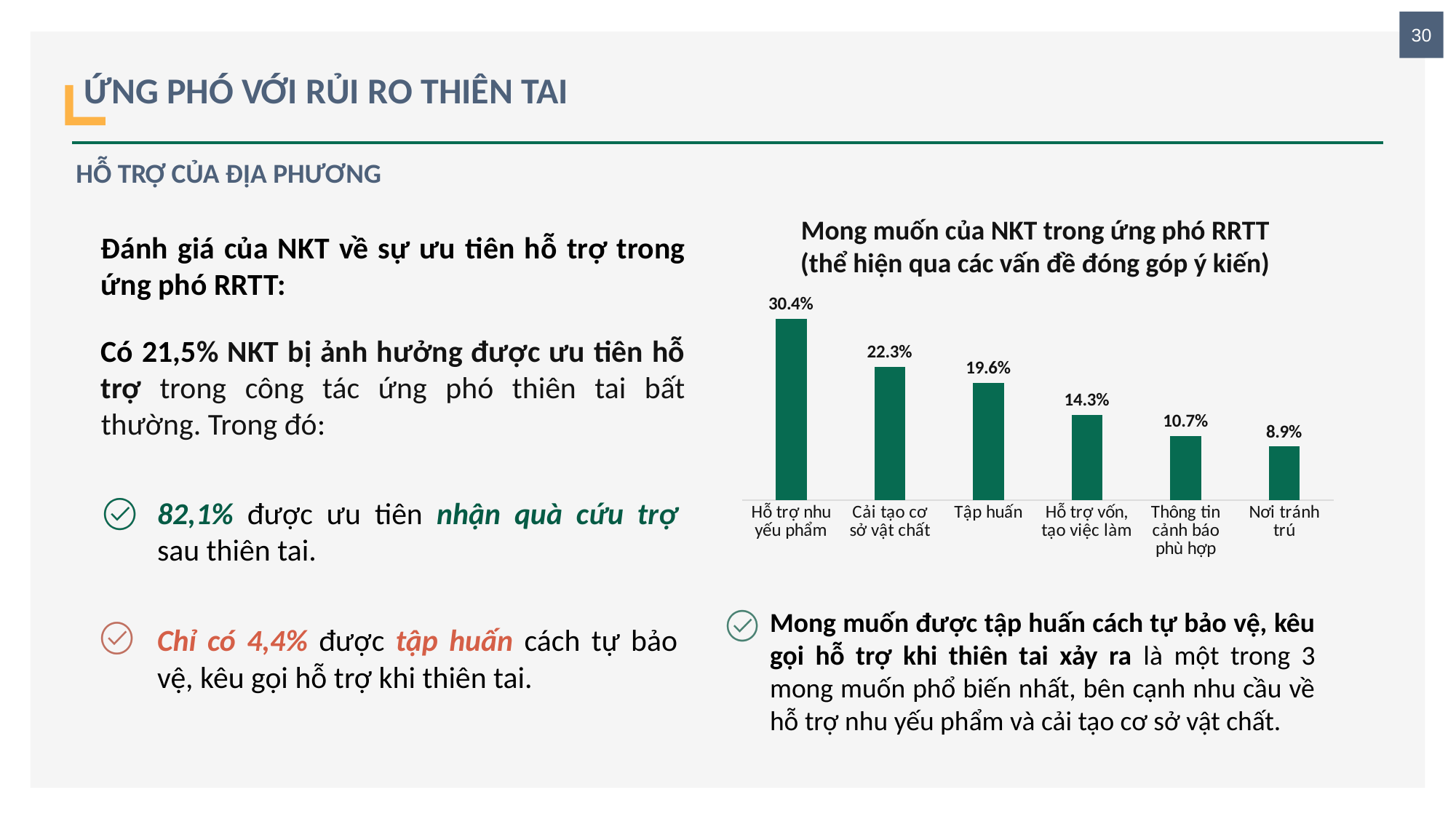
How many categories are shown in the chart? 6 What is the value for "Tập huấn" in the chart? 19.6% Do the values rise or fall from left to right across the chart? Fall Which is larger, the value for "Cải tạo cơ sở vật chất" or the value for "Tập huấn"? Cải tạo cơ sở vật chất What is the value for "Nơi tránh trú" in the chart? 8.9% What is the difference between the values for "Hỗ trợ nhu yếu phẩm" and "Cải tạo cơ sở vật chất"? 8.1% Which category has the highest value in the chart? Hỗ trợ nhu yếu phẩm What is the difference between the values for "Hỗ trợ vốn, tạo việc làm" and "Nơi tránh trú"? 5.4% What is the value for "Thông tin cảnh báo phù hợp" in the chart? 10.7% What is the value for "Hỗ trợ nhu yếu phẩm" in the chart? 30.4% Which category has the lowest value in the chart? Nơi tránh trú What kind of chart is shown on the slide? Bar chart